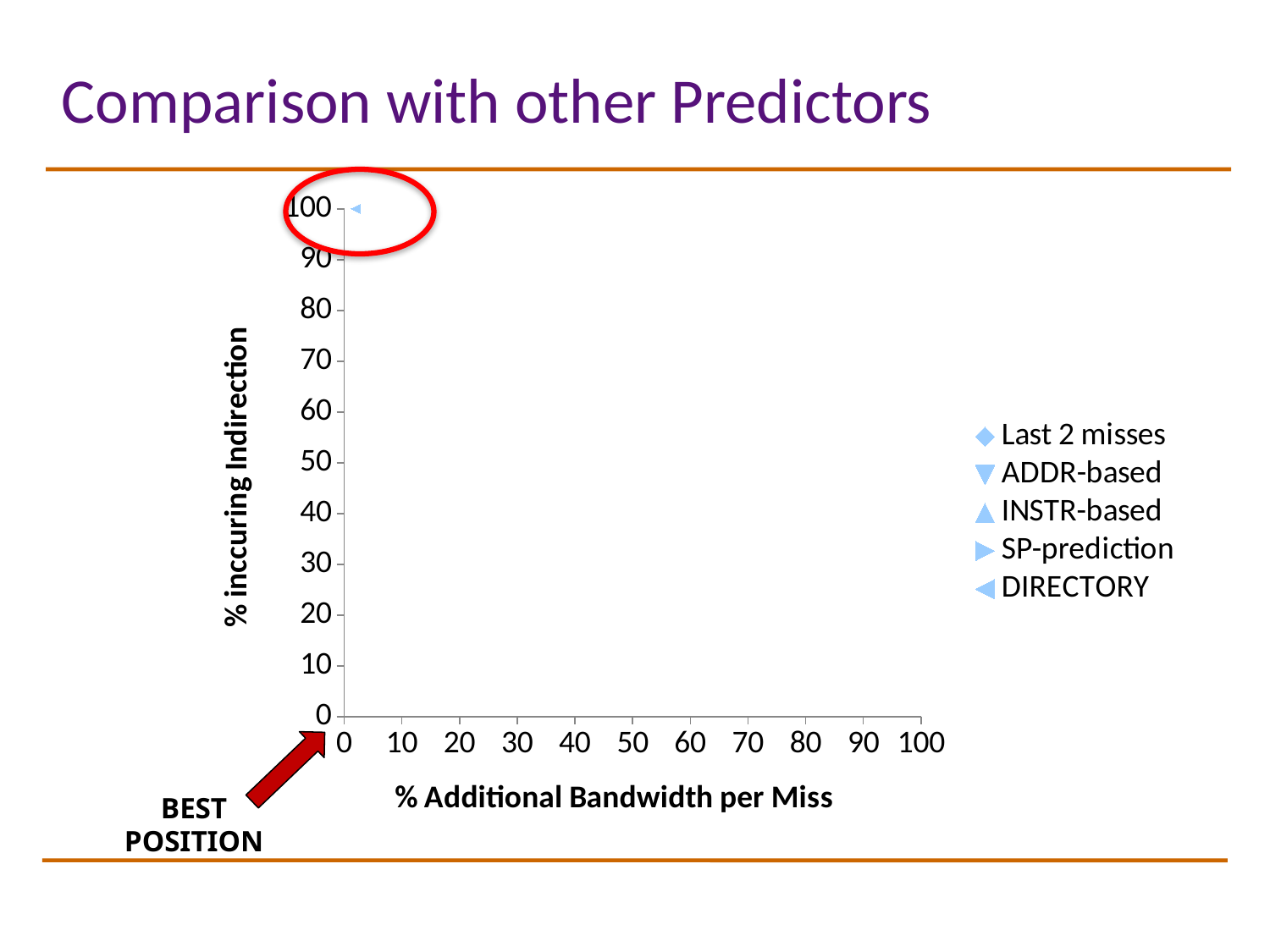
What is the title of the chart's x axis? % Additional Bandwidth per Miss Is the % Additional Bandwidth per Miss value for the DIRECTORY point greater or less than 10? less What is the maximum value shown on the x axis? 100 Is the % incurring Indirection value for the DIRECTORY point greater or less than 90? greater What is the title of the chart's y axis? % inccuring Indirection How many series does the chart legend list? 5 How many data points are visibly plotted on the chart? 1 What kind of chart is shown on the slide? scatter chart